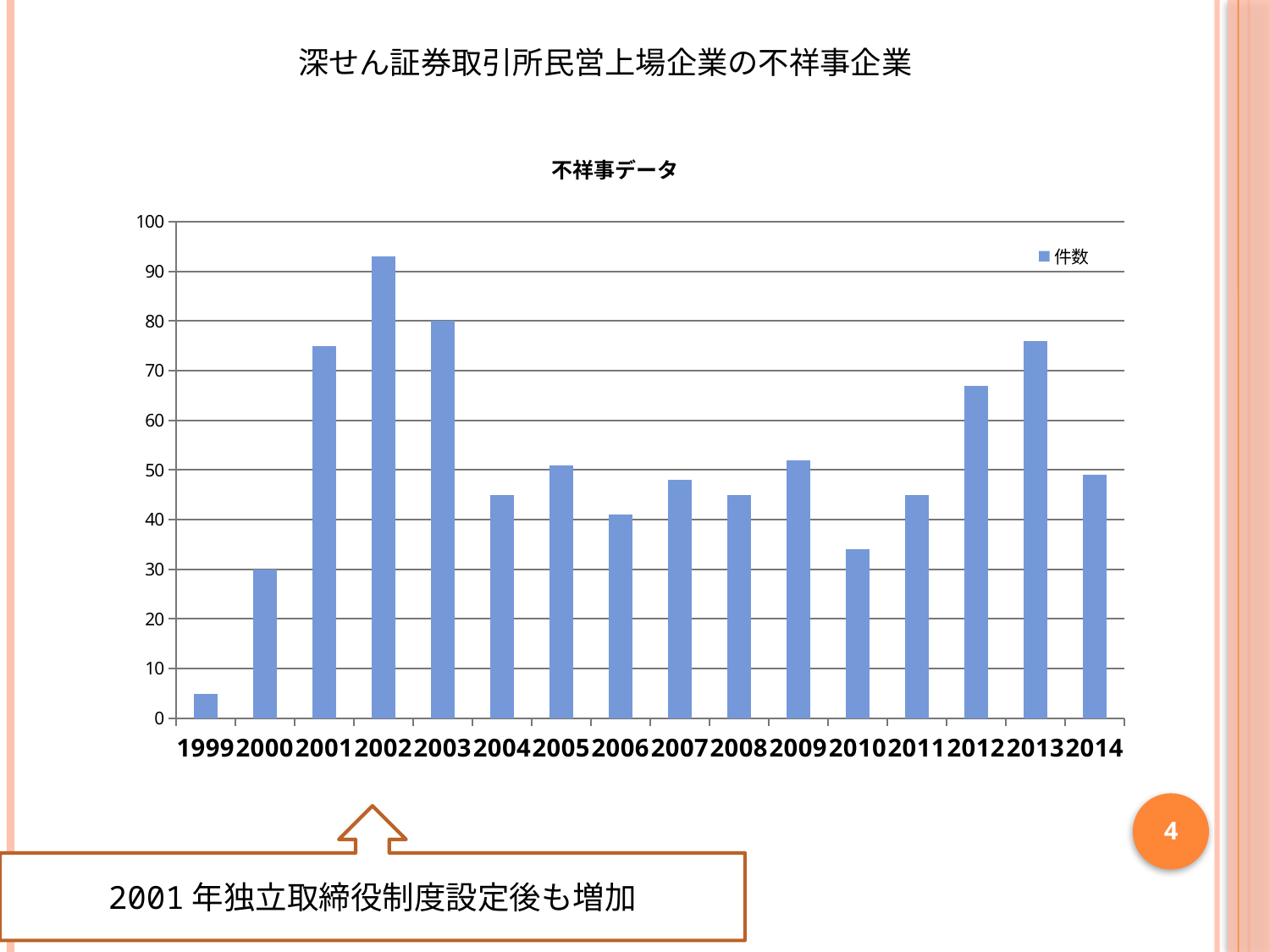
What is the title of the chart? 不祥事データ Which is larger, the value for 2012 or the value for 2010? 2012 Do the values rise or fall from 1999 to 2002? rise Is the value for 2002 greater or less than 90? greater Which year has the lowest value in the chart? 1999 What type of chart is shown on the slide? bar chart Is the value for 2010 greater or less than 40? less Which year has the highest value in the chart? 2002 How many series does the legend list? 1 What is the value for 2000? 30 How many years are shown on the x axis of the chart? 16 What is the value for 2003? 80